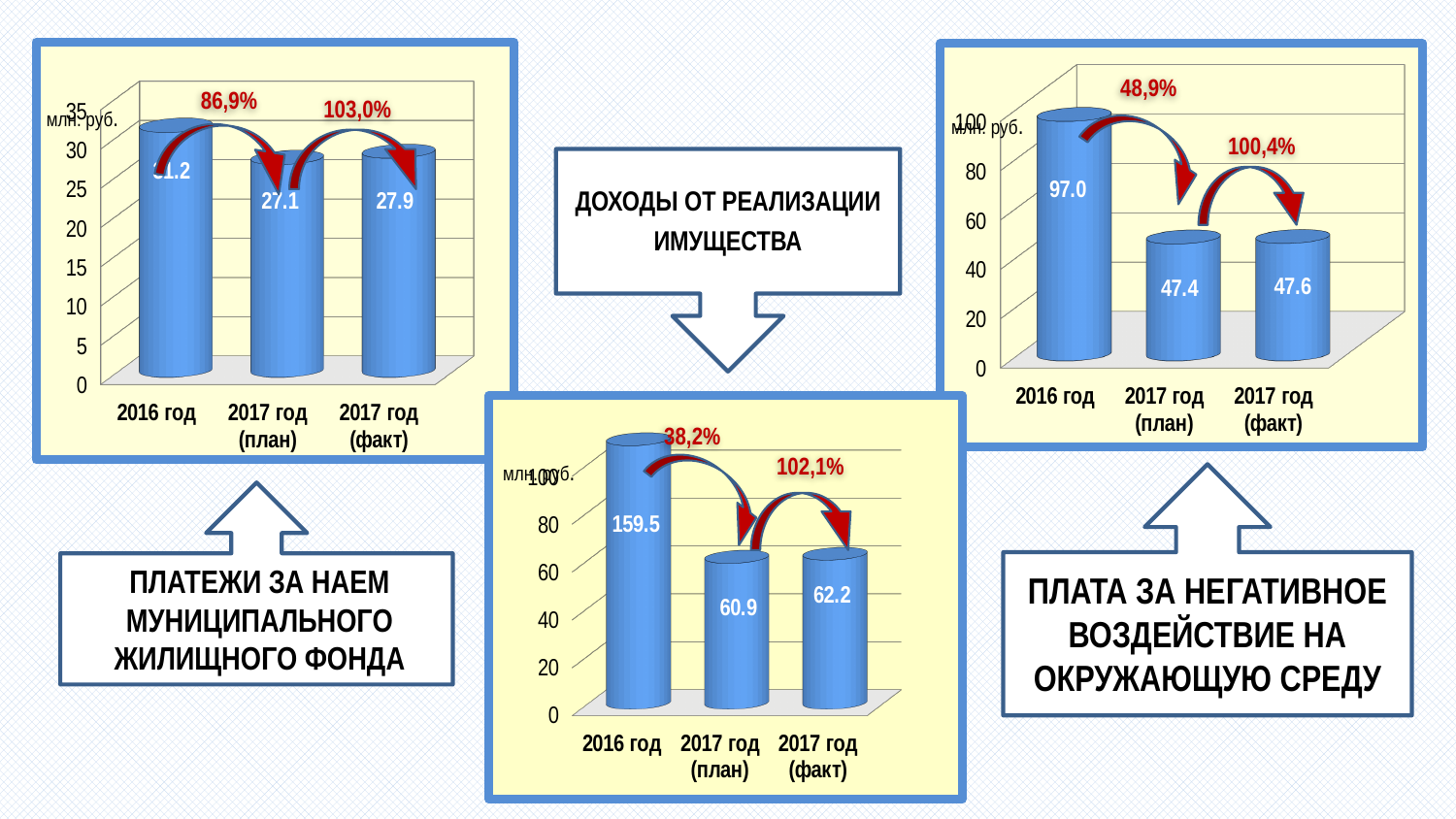
In the chart for 'Плата за негативное воздействие на окружающую среду' (right), what is the value for 2016 год? 97.0 In the chart for 'Доходы от реализации имущества' (middle), what is the difference between the 2017 год (факт) and 2017 год (план) values? 1.3 What percentage is shown above the arrow from 2017 год (план) to 2017 год (факт) in the chart for 'Плата за негативное воздействие на окружающую среду' (right)? 100,4% In the chart for 'Платежи за наем муниципального жилищного фонда' (left), what is the value for 2017 год (план)? 27.1 How many categories are shown on the x axis of the chart for 'Доходы от реализации имущества' (middle)? 3 In the chart for 'Плата за негативное воздействие на окружающую среду' (right), which category has the lowest value? 2017 год (план) In the chart for 'Доходы от реализации имущества' (middle), what is the value for 2017 год (факт)? 62.2 In the chart for 'Платежи за наем муниципального жилищного фонда' (left), what is the value for 2017 год (факт)? 27.9 In the chart for 'Плата за негативное воздействие на окружающую среду' (right), what is the difference between the 2016 год and 2017 год (факт) values? 49.4 In the chart for 'Доходы от реализации имущества' (middle), what is the value for 2016 год? 159.5 In the chart for 'Доходы от реализации имущества' (middle), which category has the highest value? 2016 год In the chart for 'Плата за негативное воздействие на окружающую среду' (right), what is the value for 2017 год (план)? 47.4